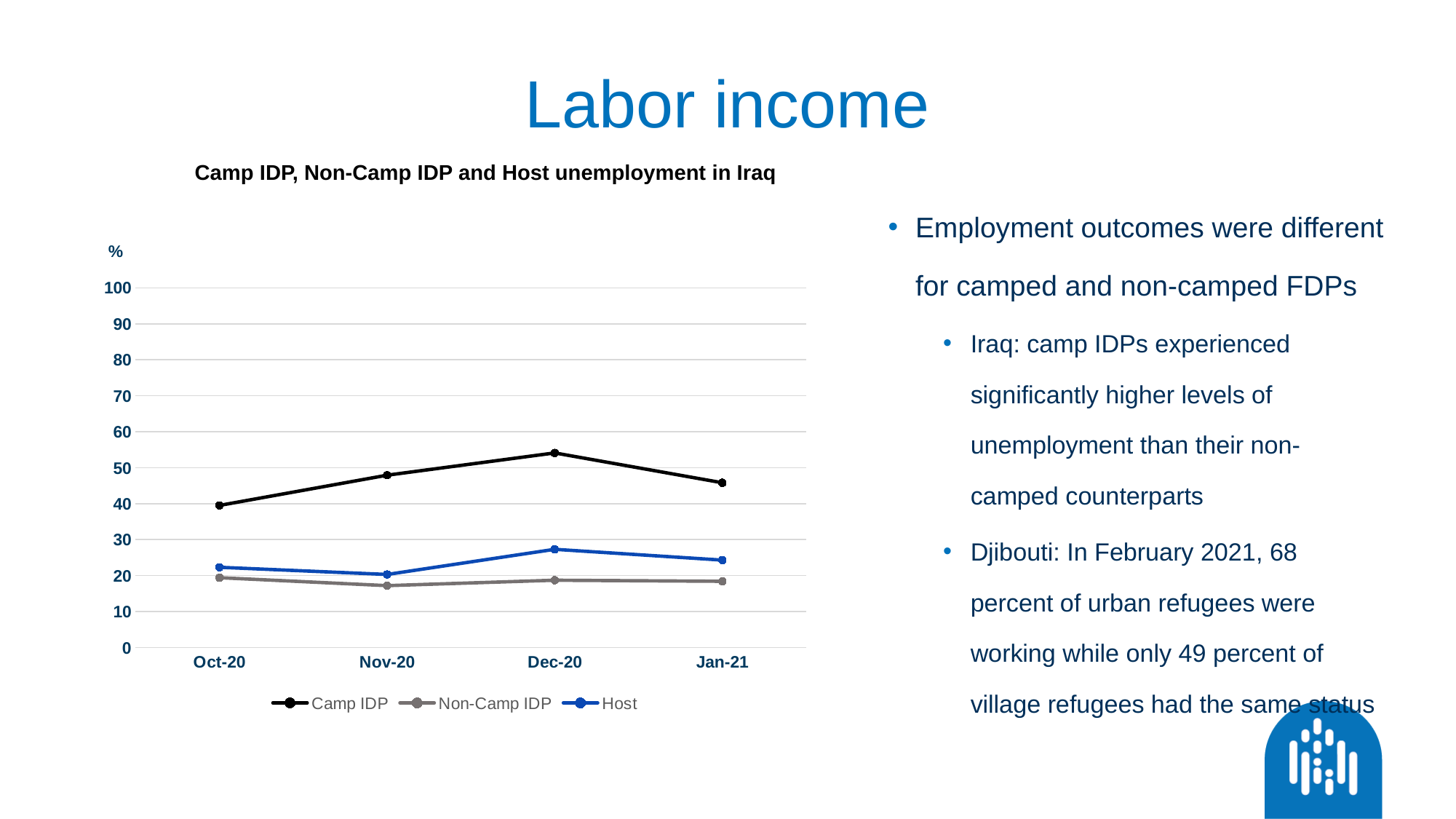
Does the Camp IDP series rise or fall from Oct-20 to Dec-20? rise Which series has the higher value in Dec-20, Camp IDP or Host? Camp IDP How many time points are plotted along the x axis? 4 Is the Camp IDP value for Dec-20 greater or less than 50? greater Is the Host value for Nov-20 greater or less than 30? less In which month does the Camp IDP series reach its highest value? Dec-20 In which month does the Camp IDP series have its lowest value? Oct-20 How many series does the legend list? 3 What kind of chart is shown on the slide? line chart What is the title of the chart? Camp IDP, Non-Camp IDP and Host unemployment in Iraq Which series has the lower value in Jan-21, Non-Camp IDP or Host? Non-Camp IDP Is the Non-Camp IDP value for Oct-20 greater or less than 30? less